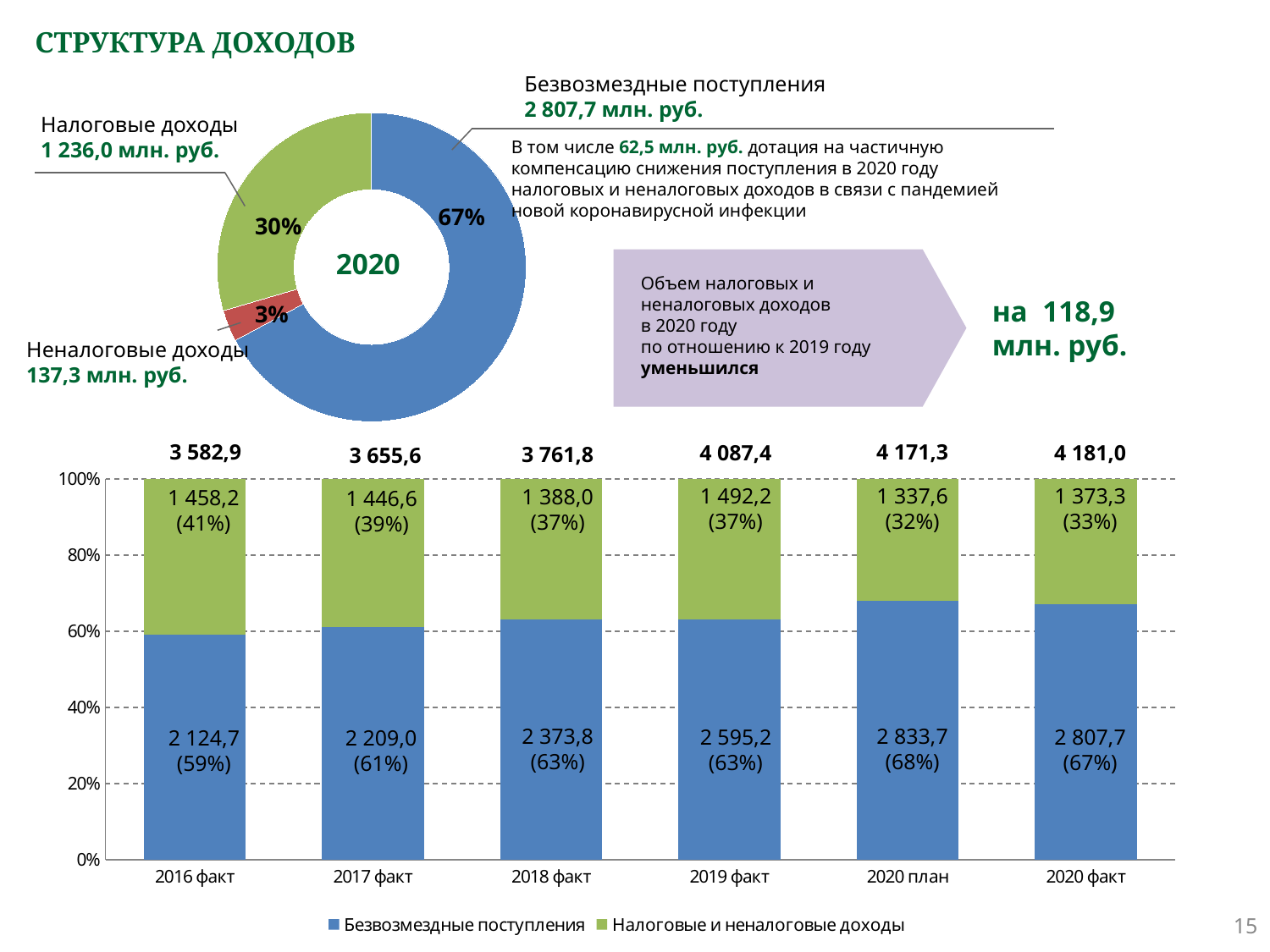
What type of chart is shown at the bottom of the slide? Stacked bar chart In the donut chart, what is the value shown for Налоговые доходы? 1 236,0 млн. руб. In the donut chart, how many segments are shown? 3 In the donut chart, which category has the smallest share? Неналоговые доходы In the stacked bar chart at the bottom, what is the value of Безвозмездные поступления for 2018 факт? 2 373,8 In the stacked bar chart at the bottom, what percentage does Налоговые и неналоговые доходы make up in 2020 план? 32% In the stacked bar chart at the bottom, what is the total shown above the 2019 факт bar? 4 087,4 In the donut chart, what share of 2020 income is Безвозмездные поступления? 67% In the stacked bar chart at the bottom, which year has the highest total? 2020 факт In the stacked bar chart at the bottom, how many series does the legend list? 2 In the stacked bar chart at the bottom, how many bars are there? 6 In the stacked bar chart at the bottom, what is the difference between the Безвозмездные поступления values for 2020 план and 2020 факт? 26,0